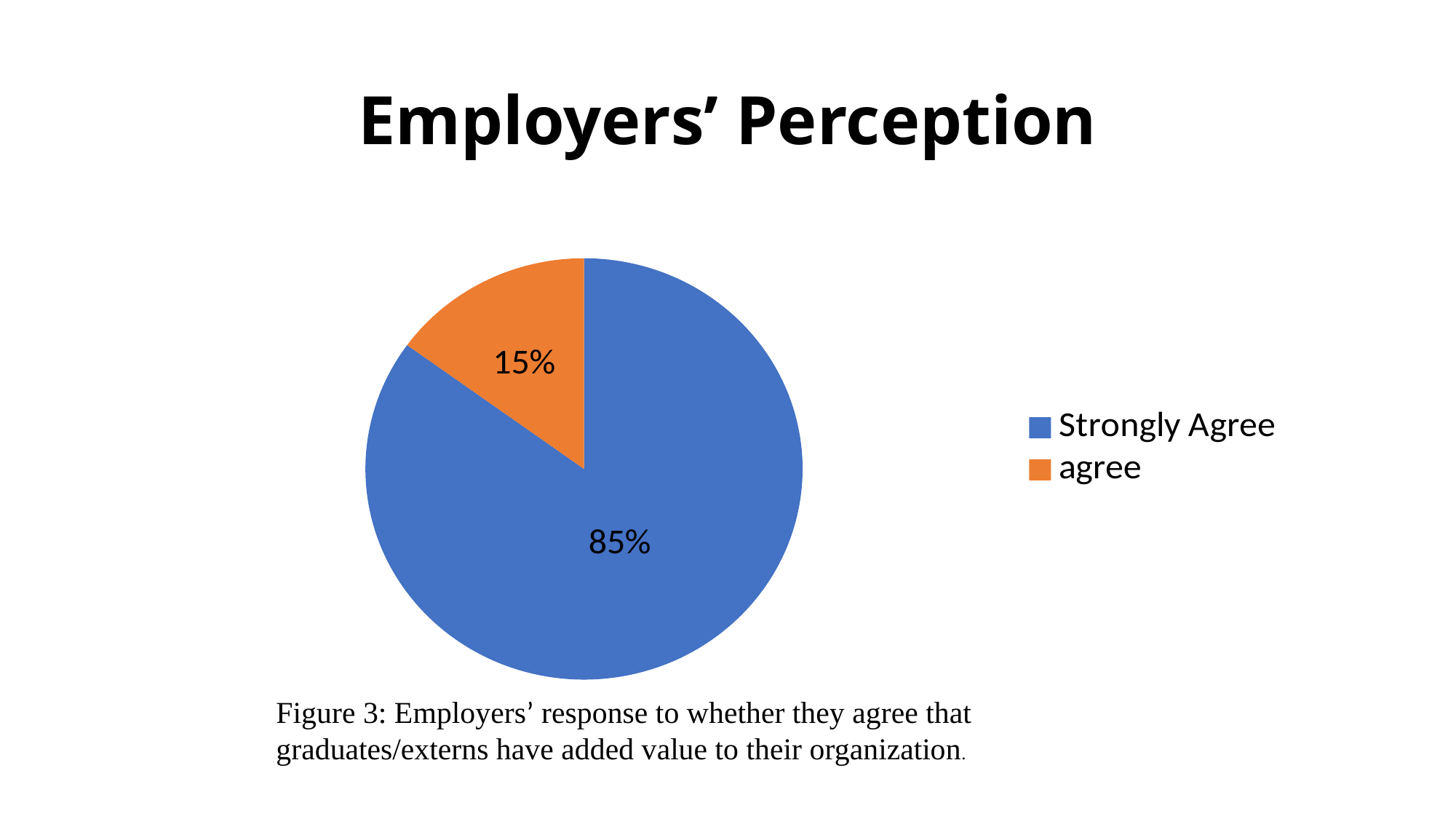
What colour is the "agree" slice? orange Which category has the largest slice of the pie? Strongly Agree Which slice is larger, "Strongly Agree" or "agree"? Strongly Agree How many entries does the legend list? 2 Which category has the smallest slice of the pie? agree What share of the pie is labelled "agree"? 15% What is the difference in percentage points between the "Strongly Agree" and "agree" slices? 70 How many categories does the pie chart show? 2 What share of the pie is labelled "Strongly Agree"? 85% What is the title shown above the chart? Employers' Perception Is the share for "Strongly Agree" greater or less than 50%? greater What kind of chart is shown on the slide? pie chart